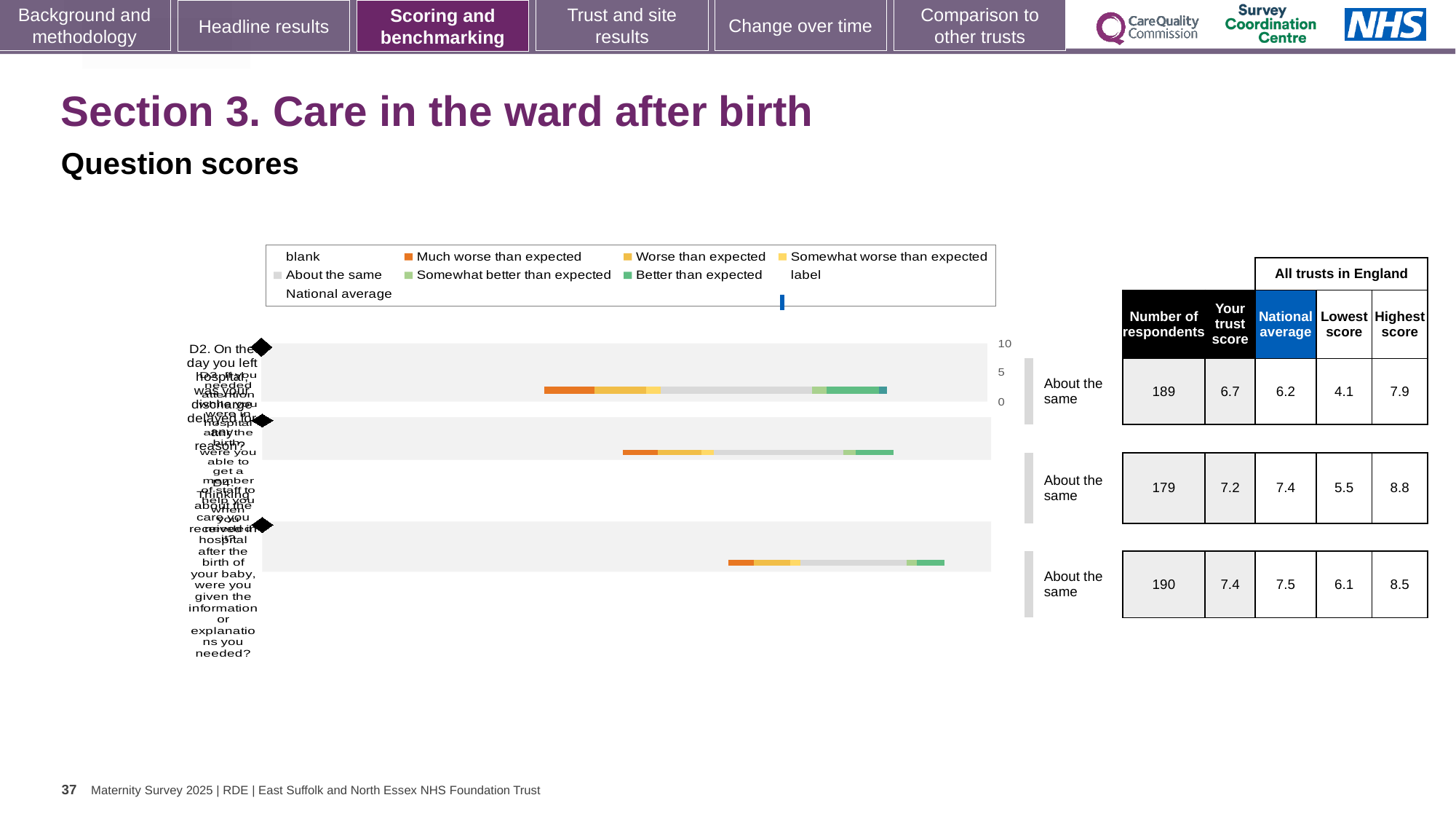
In the table beside the chart, what is the number of respondents for the first row? 189 How many stacked bars are plotted in the chart? 3 In the table beside the chart, what is the difference between the highest score and the lowest score in the first row? 3.8 In the table beside the chart, which row has the lowest 'Lowest score' value? the first row (4.1) In the table beside the chart, is the trust score for the first row higher or lower than the national average for that row? higher Which legend entry is shown in orange? Much worse than expected In the table beside the chart, what is the national average for the third row? 7.5 In the table beside the chart, which row has the highest number of respondents? the third row (190) In the table beside the chart, what is the 'Your trust score' value for the second row? 7.2 What is the highest value shown on the chart's axis? 10 What kind of chart is shown on the slide? bar chart